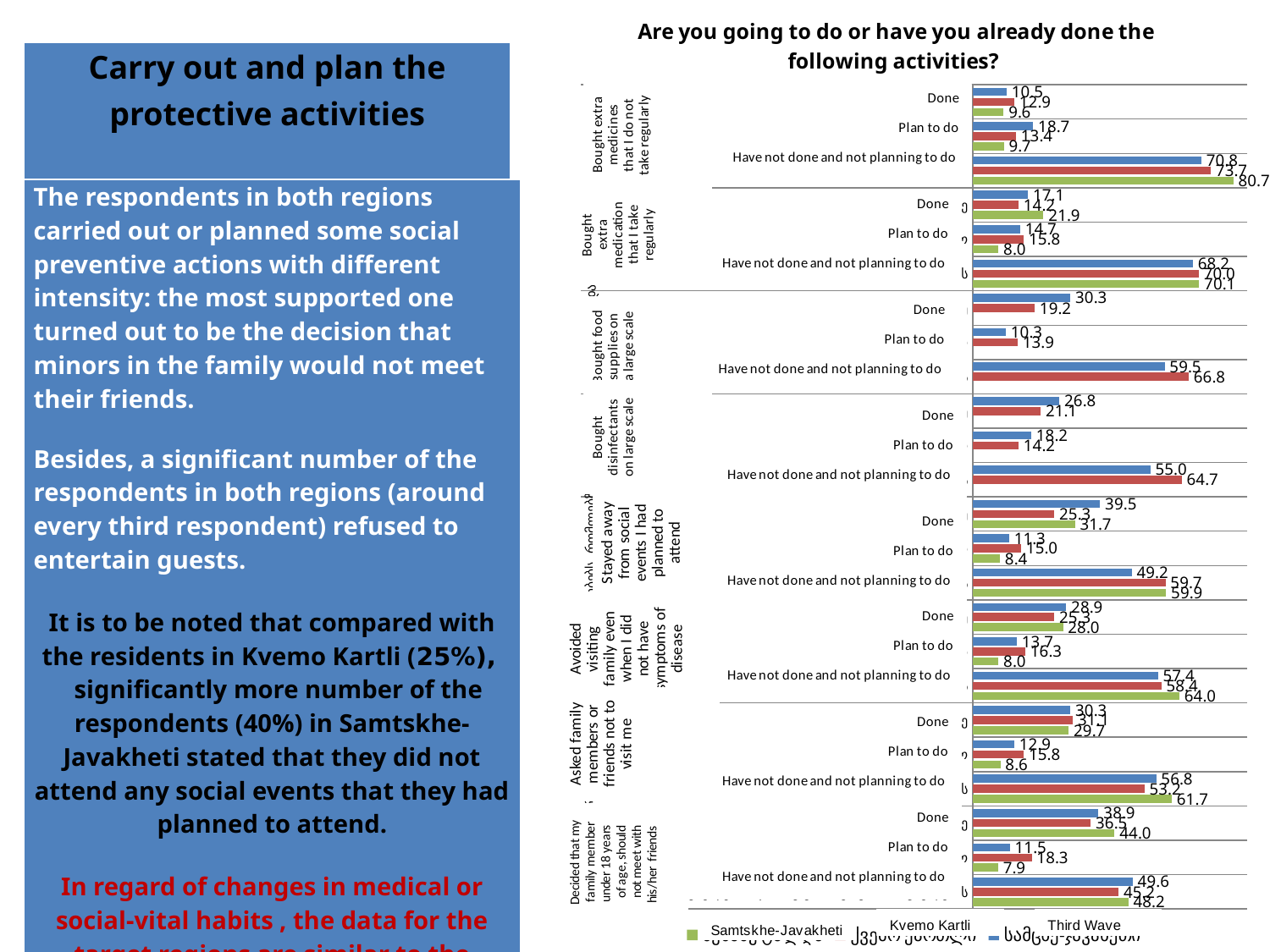
What is the Samtskhe-Javakheti value for 'Done' under 'Decided that my family member under 18 years of age should not meet with his/her friends'? 38.9 How many series does the chart legend list? 3 What is the title of the chart? Are you going to do or have you already done the following activities? What is the Samtskhe-Javakheti value for 'Have not done and not planning to do' under 'Bought extra medicines that I do not take regularly'? 70.8 What is the difference between the Samtskhe-Javakheti and Third Wave values for 'Done' under 'Decided that my family member under 18 years of age should not meet with his/her friends'? 5.1 What is the Kvemo Kartli value for 'Done' under 'Bought food supplies on a large scale'? 19.2 What is the Third Wave value for 'Done' under 'Stayed away from social events I had planned to attend'? 31.7 What type of chart is shown on the slide? bar chart What is the Kvemo Kartli value for 'Have not done and not planning to do' under 'Bought disinfectants on large scale'? 64.7